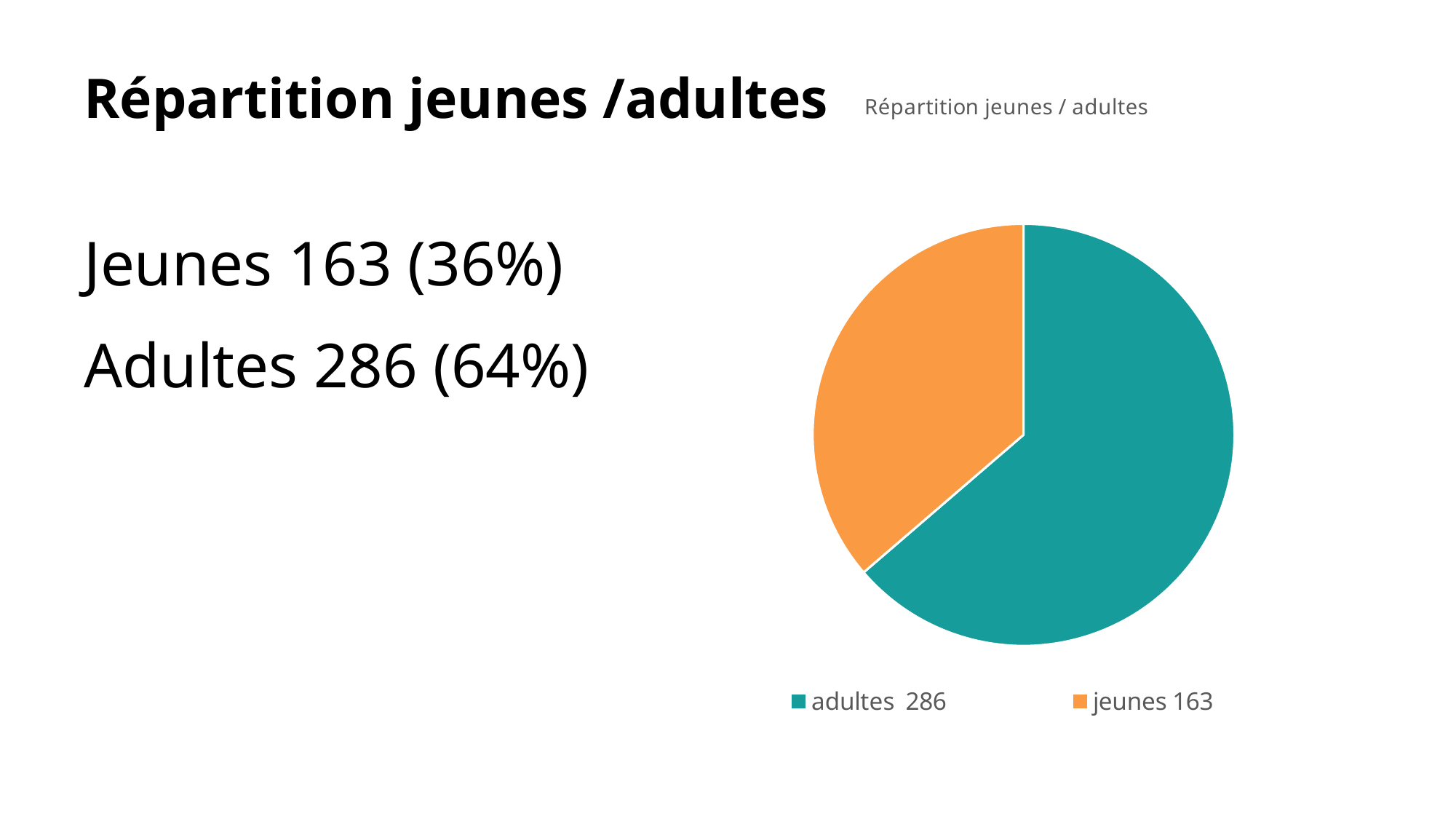
What is the difference between the adultes and jeunes values? 123 Which slice of the pie chart is the largest? adultes What share of the pie does the jeunes slice represent? 36% Which slice of the pie chart is the smallest? jeunes What is the chart's title? Répartition jeunes / adultes What kind of chart is shown on the slide? pie chart What share of the pie does the adultes slice represent? 64% Which is larger, adultes or jeunes? adultes What is the value for adultes in the pie chart? 286 What is the value for jeunes in the pie chart? 163 How many slices does the pie chart have? 2 What colour is the adultes slice in the pie chart? teal